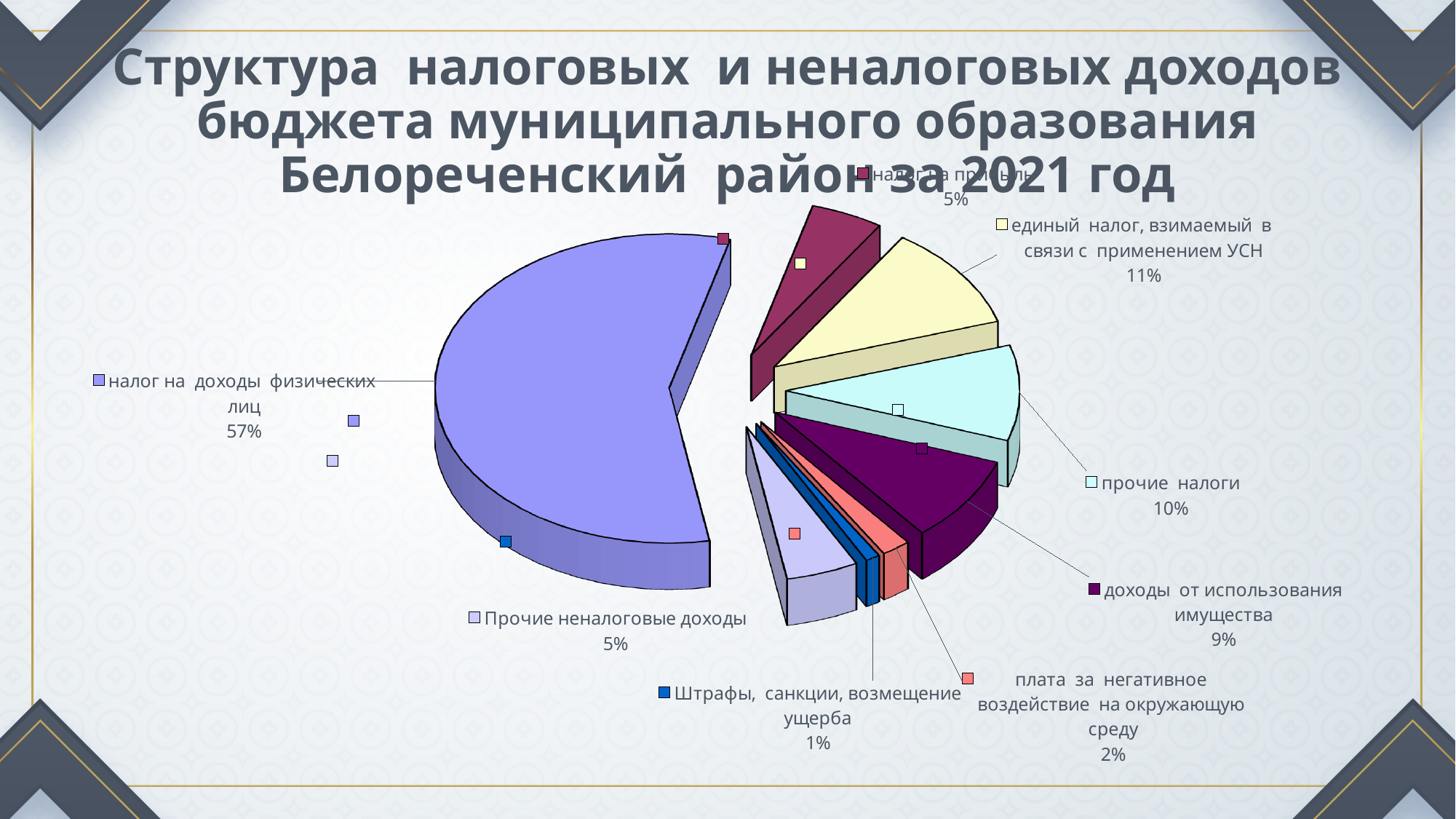
What kind of chart is shown on the slide? pie chart What share of the pie is прочие налоги? 10% Which category has the largest share of the pie? налог на доходы физических лиц Which category has the smallest share of the pie? Штрафы, санкции, возмещение ущерба What share of the pie is плата за негативное воздействие на окружающую среду? 2% What share of the pie is Прочие неналоговые доходы? 5% What is the difference in percentage points between налог на доходы физических лиц and прочие налоги? 47 What share of the pie is единый налог, взимаемый в связи с применением УСН? 11% Which is larger: the share for единый налог, взимаемый в связи с применением УСН or the share for доходы от использования имущества? единый налог, взимаемый в связи с применением УСН How many slices does the pie chart have? 8 What share of the pie is доходы от использования имущества? 9% What share of the pie is налог на доходы физических лиц? 57%